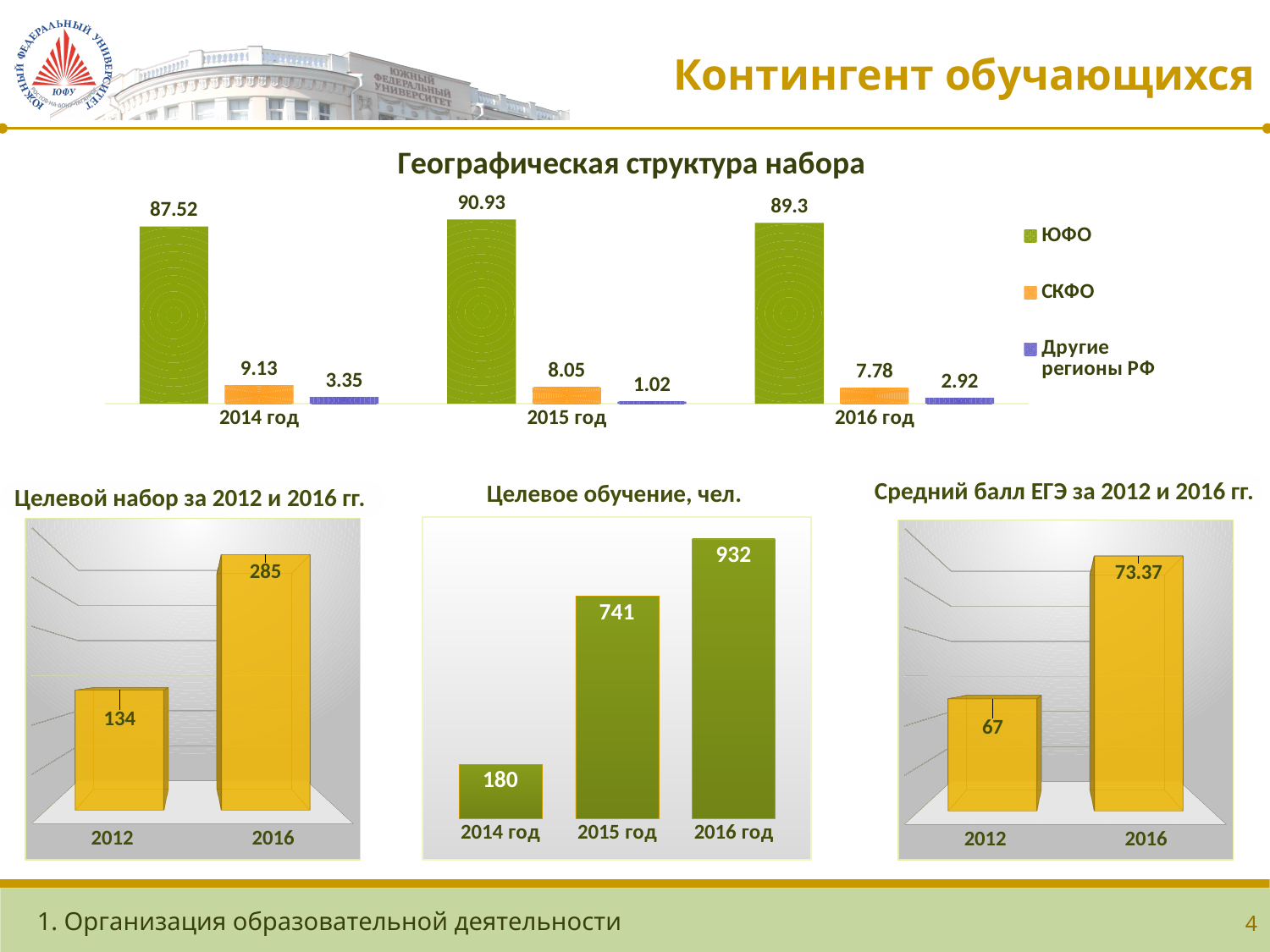
In the chart 'Географическая структура набора', what is the value for Другие регионы РФ in 2016 год? 2.92 In the chart 'Целевое обучение, чел.', do the values rise or fall from 2014 год to 2016 год? rise In the chart 'Целевой набор за 2012 и 2016 гг.', what is the difference between the values for 2016 and 2012? 151 In the chart 'Географическая структура набора', what is the difference between the ЮФО values for 2015 год and 2014 год? 3.41 In the chart 'Географическая структура набора', in which year is the value for СКФО the lowest? 2016 год In the chart 'Средний балл ЕГЭ за 2012 и 2016 гг.', what is the value for 2016? 73.37 In the chart 'Целевое обучение, чел.', how many categories are shown? 3 In the chart 'Целевое обучение, чел.', what is the value for 2015 год? 741 In the chart 'Географическая структура набора', what is the value for ЮФО in 2015 год? 90.93 In the chart 'Географическая структура набора', how many series does the legend list? 3 In the chart 'Целевой набор за 2012 и 2016 гг.', what is the value for 2012? 134 What kind of chart is 'Средний балл ЕГЭ за 2012 и 2016 гг.'? bar chart